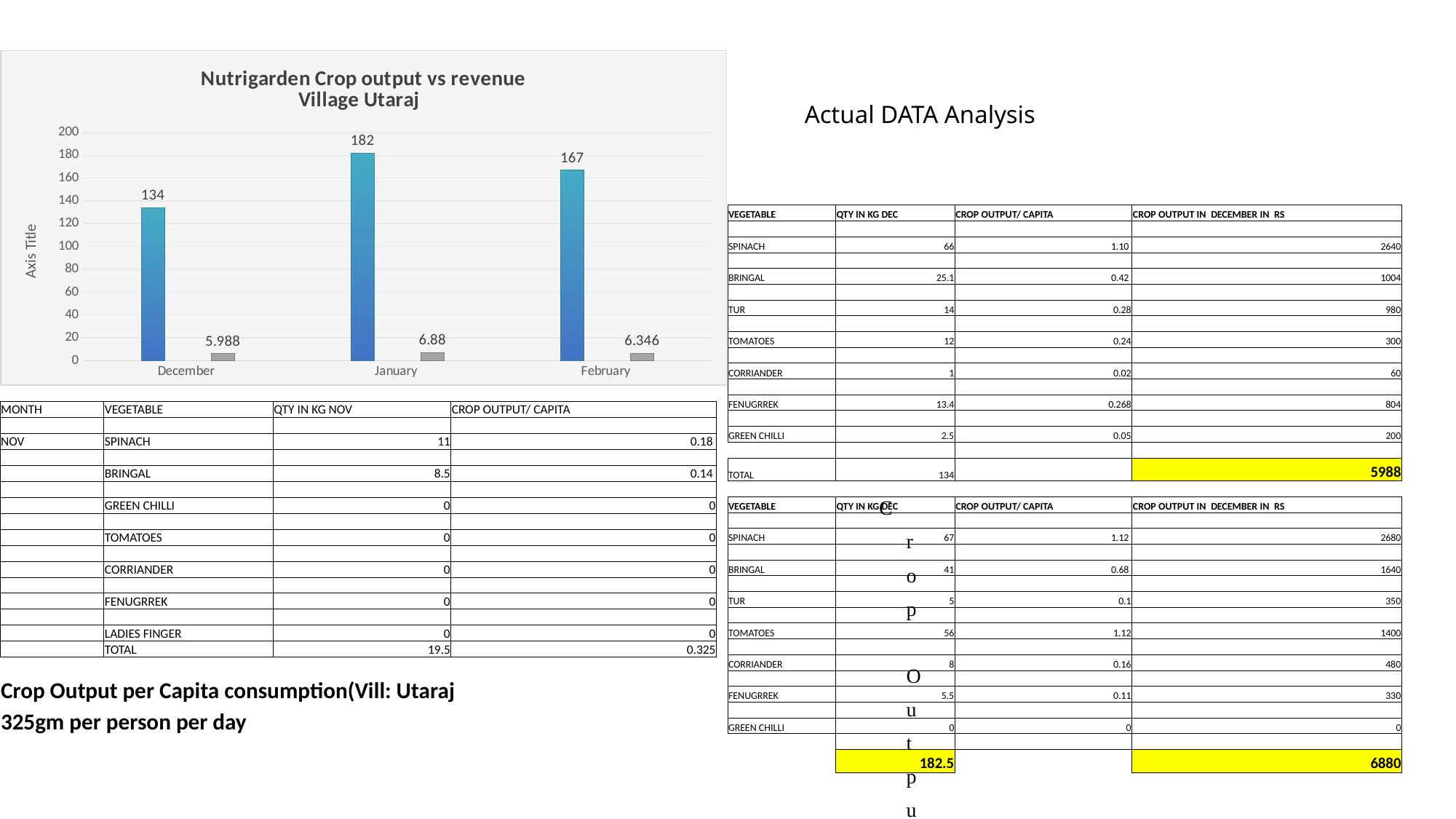
Which month has the highest blue bar in the chart? January What is the value of the grey bar for February in the chart? 6.346 What is the title of the chart on the slide? Nutrigarden Crop output vs revenue Village Utaraj What kind of chart is shown on the slide? bar chart Is the blue bar value for February greater or less than 140? greater What is the value of the grey bar for January in the chart? 6.88 Which month has the lowest grey bar in the chart? December How many months are shown on the x axis of the chart? 3 What is the value of the blue bar for January in the Nutrigarden Crop output vs revenue chart? 182 What is the value of the blue bar for December in the chart? 134 What is the difference between the blue bar values for January and February? 15 Which is larger, the blue bar for December or the blue bar for February? February